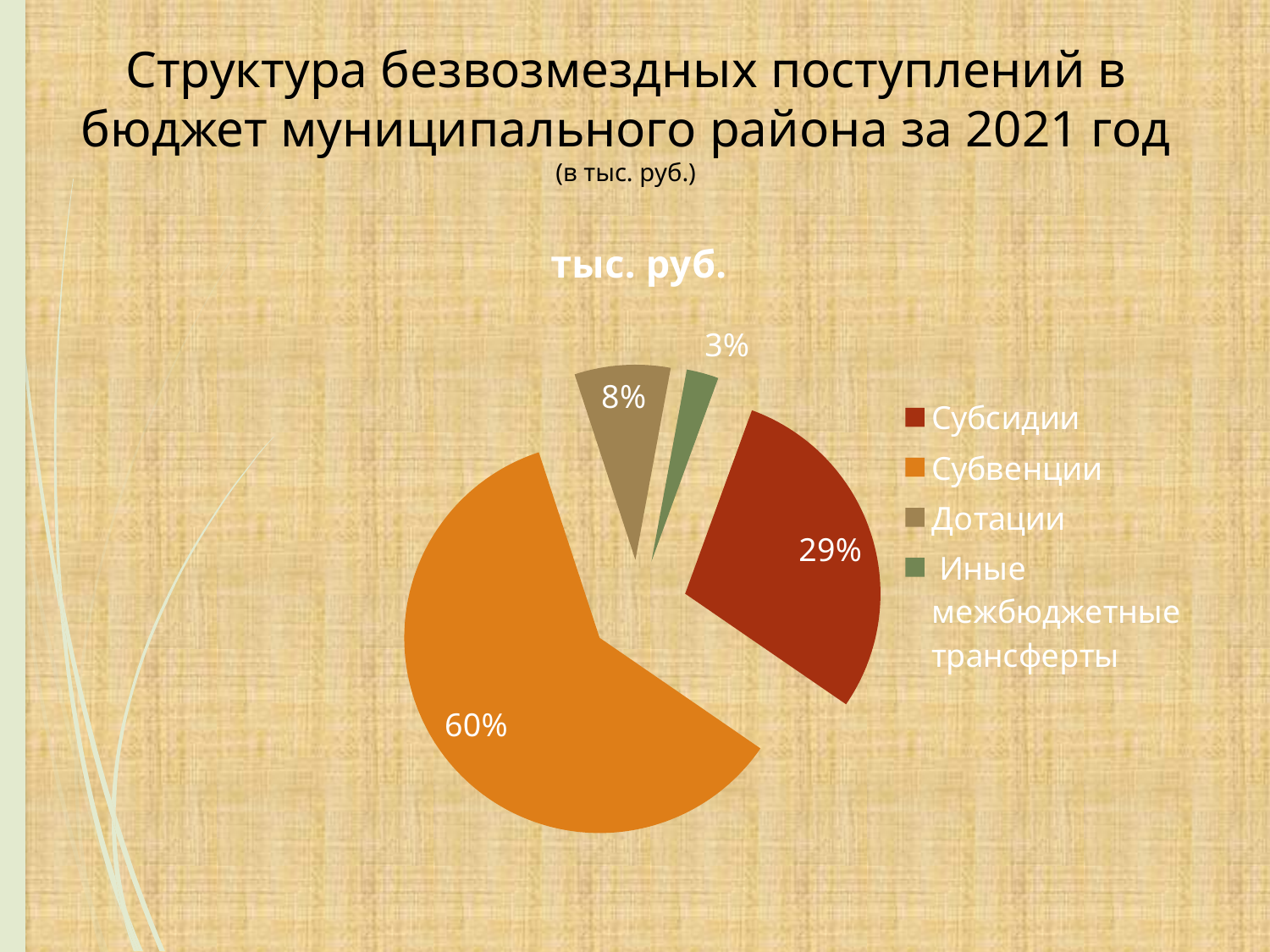
What is the difference in percentage points between Субвенции and Субсидии? 31% What share of the pie does Иные межбюджетные трансферты have? 3% What is the title shown above the pie chart? тыс. руб. Which is larger, the share for Дотации or the share for Иные межбюджетные трансферты? Дотации Which category has the smallest slice of the pie? Иные межбюджетные трансферты How many slices does the pie chart have? 4 Which colour represents Субсидии in the legend? dark red What share of the pie does Дотации have? 8% What share of the pie does Субвенции have? 60% What kind of chart is shown on the slide? pie chart Which category has the largest slice of the pie? Субвенции